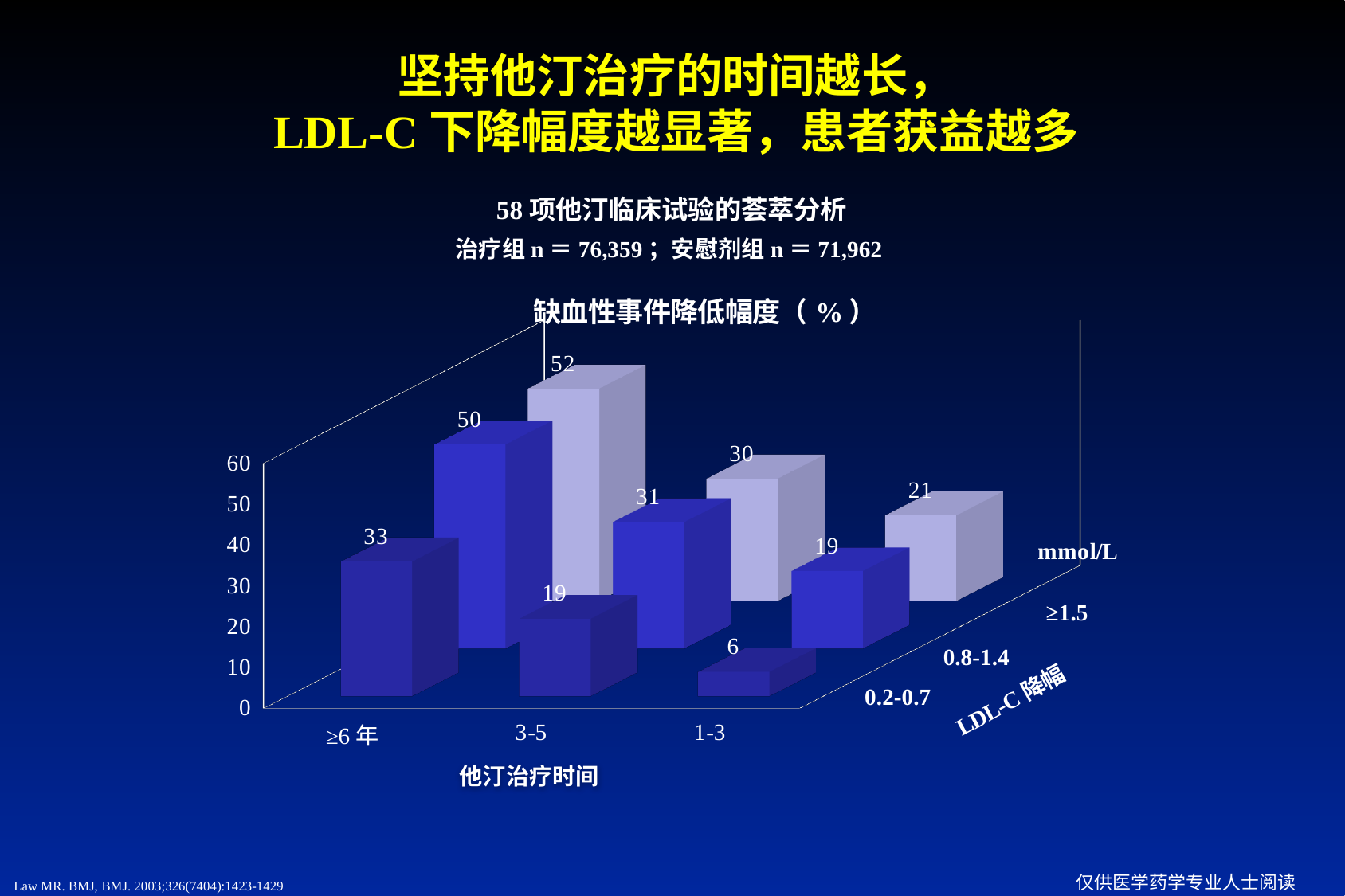
Which treatment duration has the lowest ischemic event reduction in the 0.2-0.7 mmol/L LDL-C reduction group? 1-3 Which treatment duration has the highest ischemic event reduction in the ≥1.5 mmol/L LDL-C reduction group? ≥6 年 What is the ischemic event reduction (%) for ≥6 年 of statin treatment with an LDL-C reduction of ≥1.5 mmol/L? 52 In the 1-3 year treatment group, which LDL-C reduction level gives a larger ischemic event reduction: 0.2-0.7 or ≥1.5 mmol/L? ≥1.5 What is the ischemic event reduction (%) for 3-5 years of statin treatment with an LDL-C reduction of 0.8-1.4 mmol/L? 31 How many LDL-C reduction groups (series) are plotted in the chart? 3 What type of chart is shown on the slide? 3D bar chart What is the ischemic event reduction (%) for 1-3 years of statin treatment with an LDL-C reduction of 0.2-0.7 mmol/L? 6 What is the title of the chart? 缺血性事件降低幅度（%） What is the ischemic event reduction (%) for ≥6 年 of statin treatment with an LDL-C reduction of 0.2-0.7 mmol/L? 33 What is the difference in ischemic event reduction between ≥6 年 and 1-3 years of treatment in the 0.8-1.4 mmol/L group? 31 How many statin treatment duration categories are shown on the x axis? 3